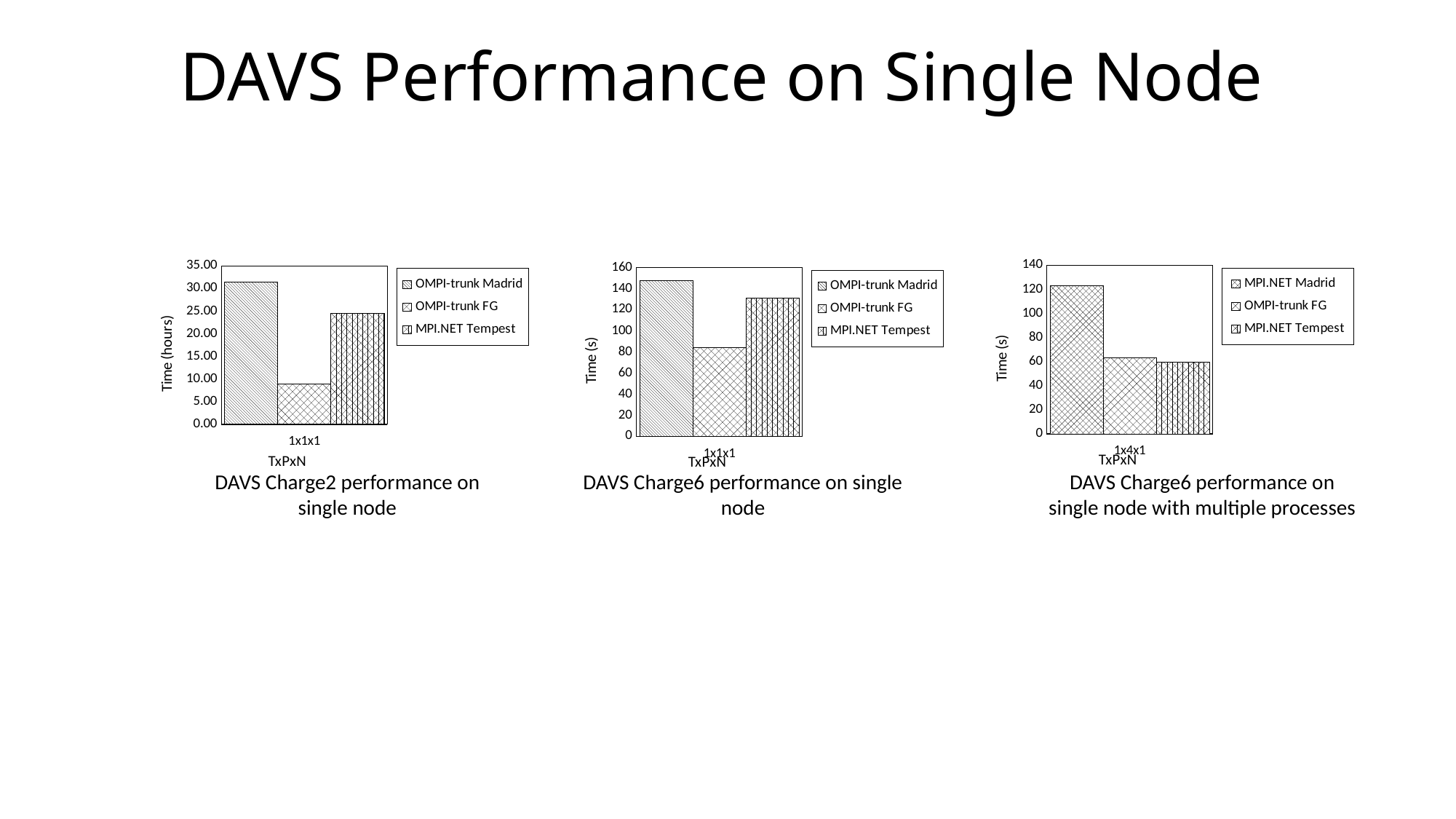
In the 'DAVS Charge6 performance on single node with multiple processes' chart, which series has the highest value? MPI.NET Madrid What kind of chart is the 'DAVS Charge2 performance on single node' chart? bar chart In the 'DAVS Charge6 performance on single node' chart, which is larger, MPI.NET Tempest or OMPI-trunk FG? MPI.NET Tempest In the 'DAVS Charge6 performance on single node' chart, which series has the highest value? OMPI-trunk Madrid In the 'DAVS Charge6 performance on single node with multiple processes' chart, is the value for MPI.NET Madrid greater or less than 100? greater In the 'DAVS Charge2 performance on single node' chart, which series has the highest value? OMPI-trunk Madrid In the 'DAVS Charge2 performance on single node' chart, which series has the lowest value? OMPI-trunk FG In the 'DAVS Charge6 performance on single node with multiple processes' chart, what is the category label on the x axis? 1x4x1 In the 'DAVS Charge2 performance on single node' chart, how many series does the legend list? 3 In the 'DAVS Charge2 performance on single node' chart, is the value for OMPI-trunk FG greater or less than 10.00? less In the 'DAVS Charge6 performance on single node' chart, is the value for OMPI-trunk FG greater or less than 100? less